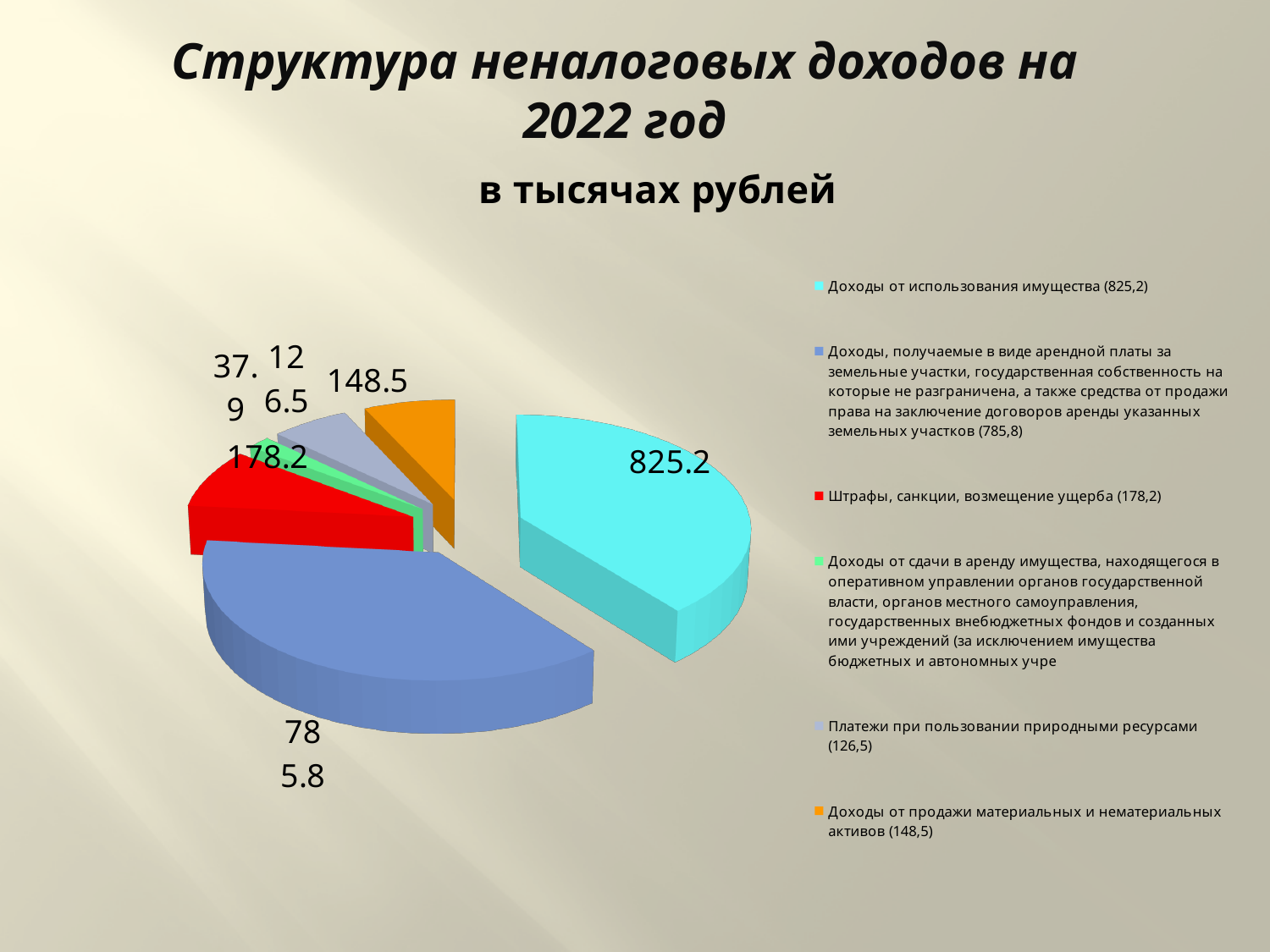
What is the difference between the value for Доходы от использования имущества (825.2) and the value for Штрафы, санкции, возмещение ущерба (178.2)? 647 What is the value of the smallest slice of the pie? 37.9 What is the value for Платежи при пользовании природными ресурсами? 126.5 Which is larger: the value for Доходы от продажи материальных и нематериальных активов or the value for Платежи при пользовании природными ресурсами? Доходы от продажи материальных и нематериальных активов Which category has the largest slice of the pie? Доходы от использования имущества What is the value for Доходы от продажи материальных и нематериальных активов? 148.5 What is the title of the chart on the slide? в тысячах рублей What kind of chart is shown on the slide? pie chart What is the value for Доходы от использования имущества? 825.2 How many entries does the legend list? 6 How many slices does the pie chart have? 6 What is the value for Штрафы, санкции, возмещение ущерба? 178.2